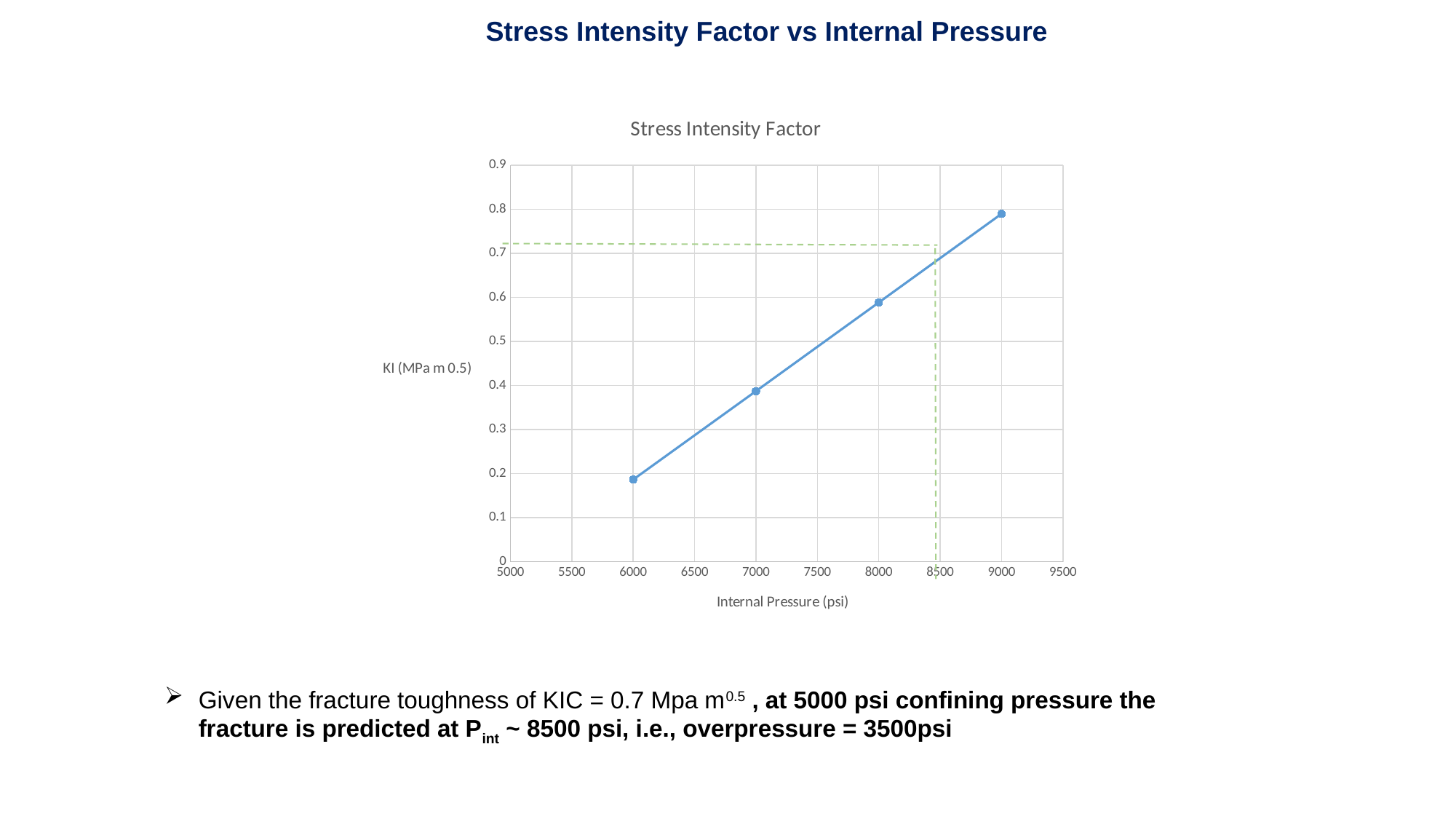
Does the stress intensity factor rise or fall as internal pressure increases? rises How many data points are plotted on the line? 4 At which internal pressure is the plotted stress intensity factor highest? 9000 Is the value at 9000 psi greater or less than 0.7? greater At which internal pressure is the plotted stress intensity factor lowest? 6000 What is the label of the x axis? Internal Pressure (psi) Which has the larger stress intensity factor, 7000 psi or 8000 psi? 8000 psi Is the value at 8000 psi greater or less than 0.5? greater What kind of chart is shown on the slide? line chart What is the title of the chart? Stress Intensity Factor